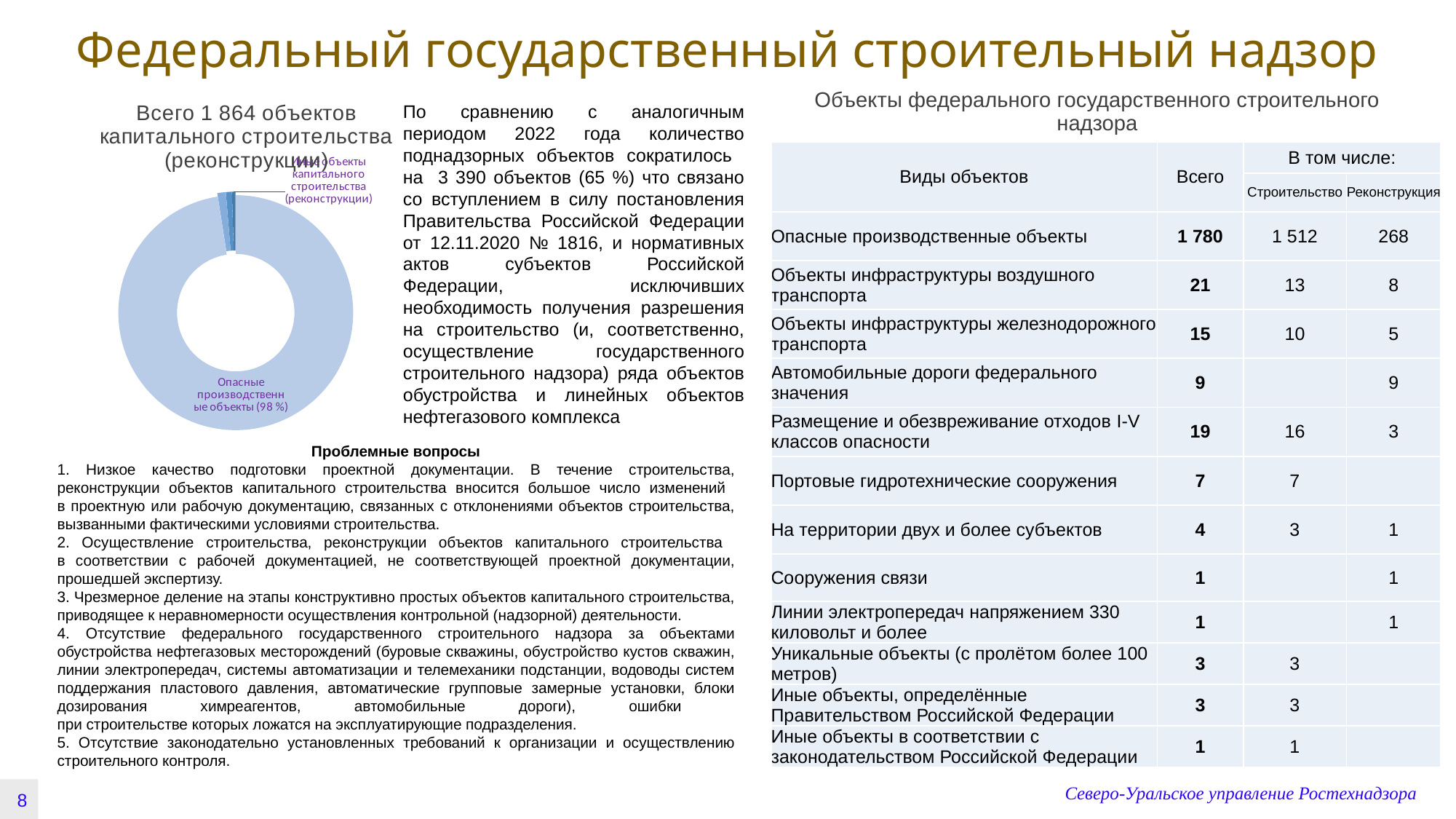
In the doughnut chart, which is larger: the slice for 'Опасные производственные объекты' or the slice for 'Иные объекты капитального строительства (реконструкции)'? Опасные производственные объекты What kind of chart is shown on the left of the slide? Doughnut (pie) chart Which category takes up the largest slice of the doughnut chart? Опасные производственные объекты According to the doughnut chart's title, how many capital construction (reconstruction) objects are there in total? 1 864 In the doughnut chart, what share of the total do 'Опасные производственные объекты' account for? 98 % What is the title of the doughnut chart on the left? Всего 1 864 объектов капитального строительства (реконструкции) Is the share of 'Опасные производственные объекты' in the doughnut chart greater or less than 50%? greater